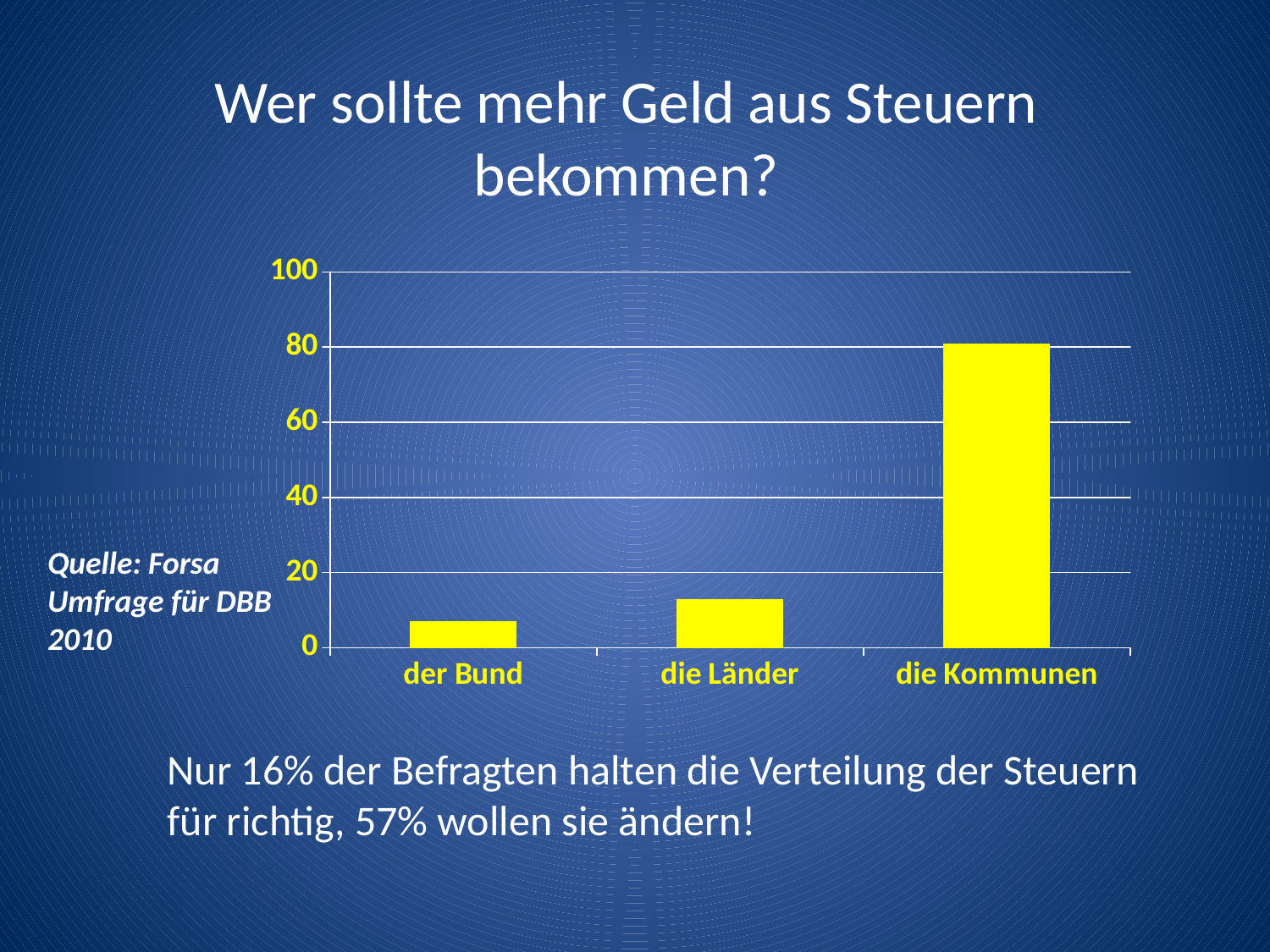
Is the value for die Kommunen greater or less than 60? greater Is the value for die Länder greater or less than 20? less Which has a larger value, die Länder or der Bund? die Länder Which category has the highest value in the chart? die Kommunen What colour are the bars in the chart? yellow Which category has the lowest value in the chart? der Bund Is the value for der Bund greater or less than 20? less What kind of chart is shown on the slide? bar chart What is the highest tick value shown on the y axis of the chart? 100 Do the values rise or fall from left to right along the x axis? rise How many categories are shown on the x axis of the chart? 3